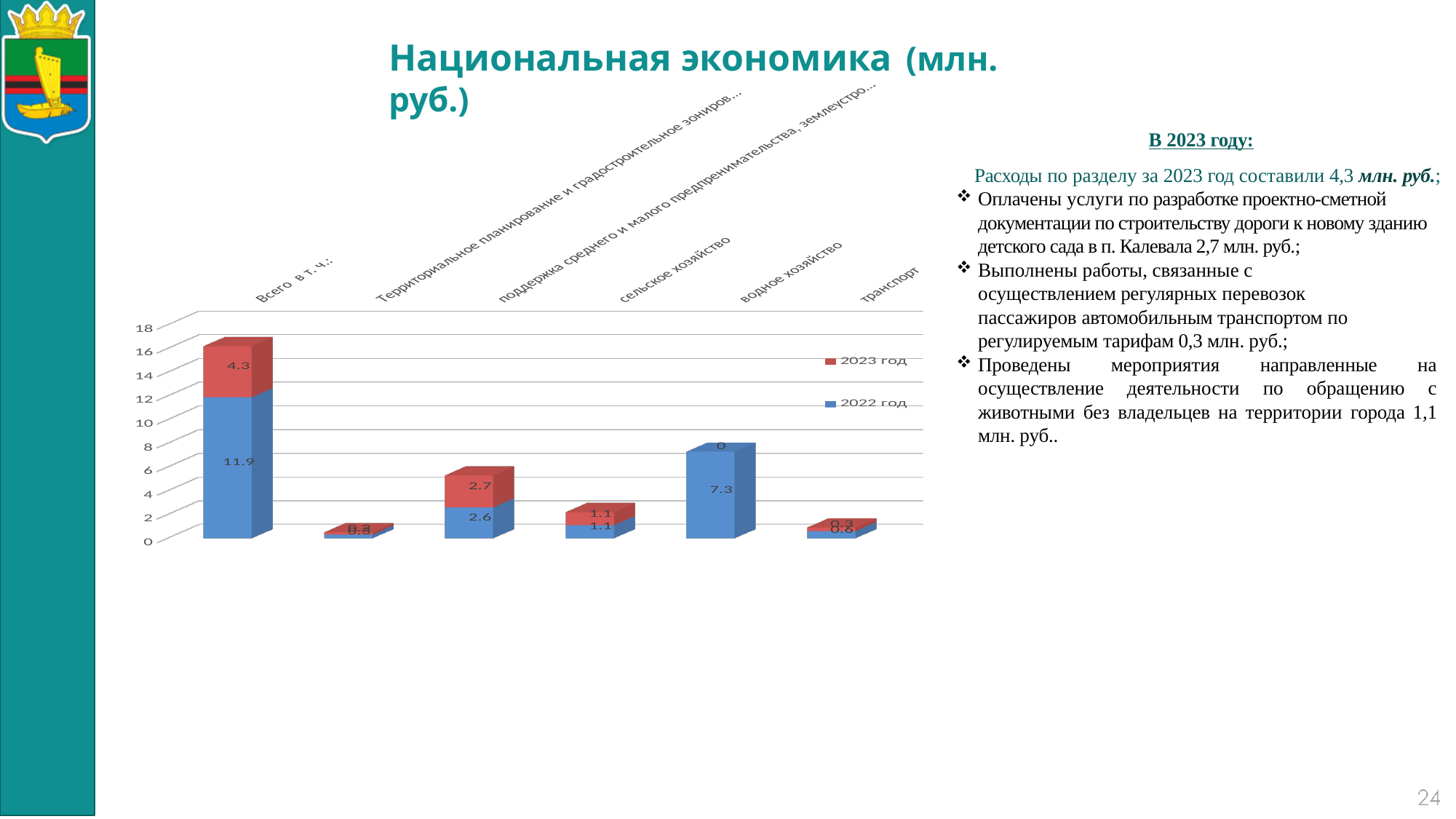
What is the value for 2022 год in the category 'Всего в т.ч.:'? 11.9 How many categories are shown along the x axis of the chart? 6 What is the value for 2022 год in the category 'водное хозяйство'? 7.3 What is the value for 2022 год in the category 'транспорт'? 0.6 Which category has the highest 2022 год value? Всего в т.ч.: What is the value for 2023 год in the category 'поддержка среднего и малого предпринимательства'? 2.7 What is the value for 2023 год in the category 'Всего в т.ч.:'? 4.3 What is the value for 2023 год in the category 'водное хозяйство'? 0 How many series does the chart legend list? 2 What is the difference between the 2022 год and 2023 год values for 'Всего в т.ч.:'? 7.6 What is the total of the stacked bar for 'поддержка среднего и малого предпринимательства'? 5.3 What kind of chart is shown on the slide? stacked bar chart